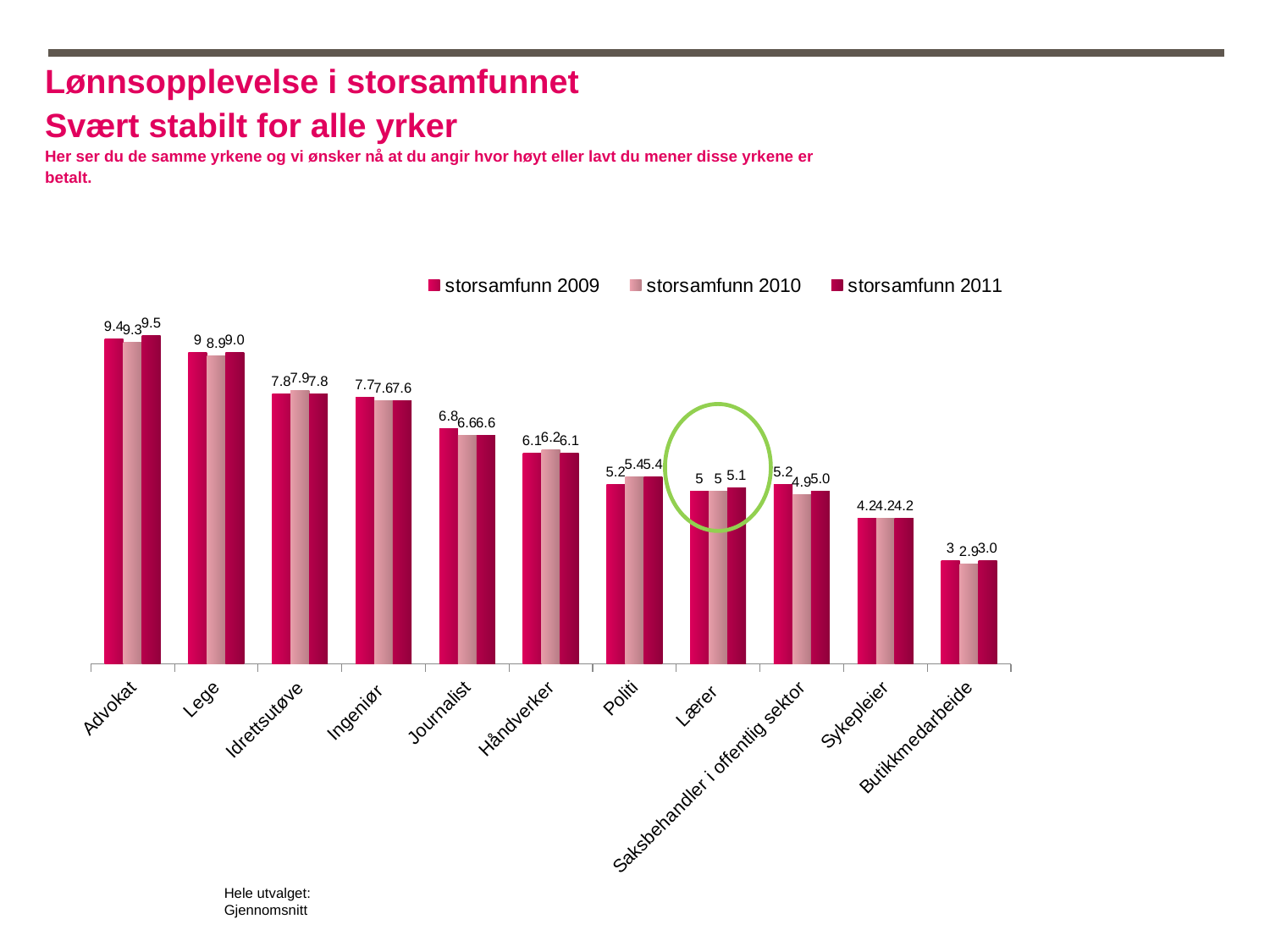
What is the difference between the storsamfunn 2011 values for Advokat and Lege? 0.5 Which is larger: the storsamfunn 2009 value for Journalist or for Håndverker? Journalist How many categories are shown on the x axis? 11 What is the value for Saksbehandler i offentlig sektor in the storsamfunn 2010 series? 4.9 Which category has the lowest value in the storsamfunn 2010 series? Butikkmedarbeide Which category has the highest value in the storsamfunn 2009 series? Advokat Which category is highlighted with a green circle on the chart? Lærer What is the value for Butikkmedarbeide in the storsamfunn 2009 series? 3 What kind of chart is shown on the slide? Bar chart What is the value for Advokat in the storsamfunn 2011 series? 9.5 What is the value for Lærer in the storsamfunn 2011 series? 5.1 How many series does the legend list? 3